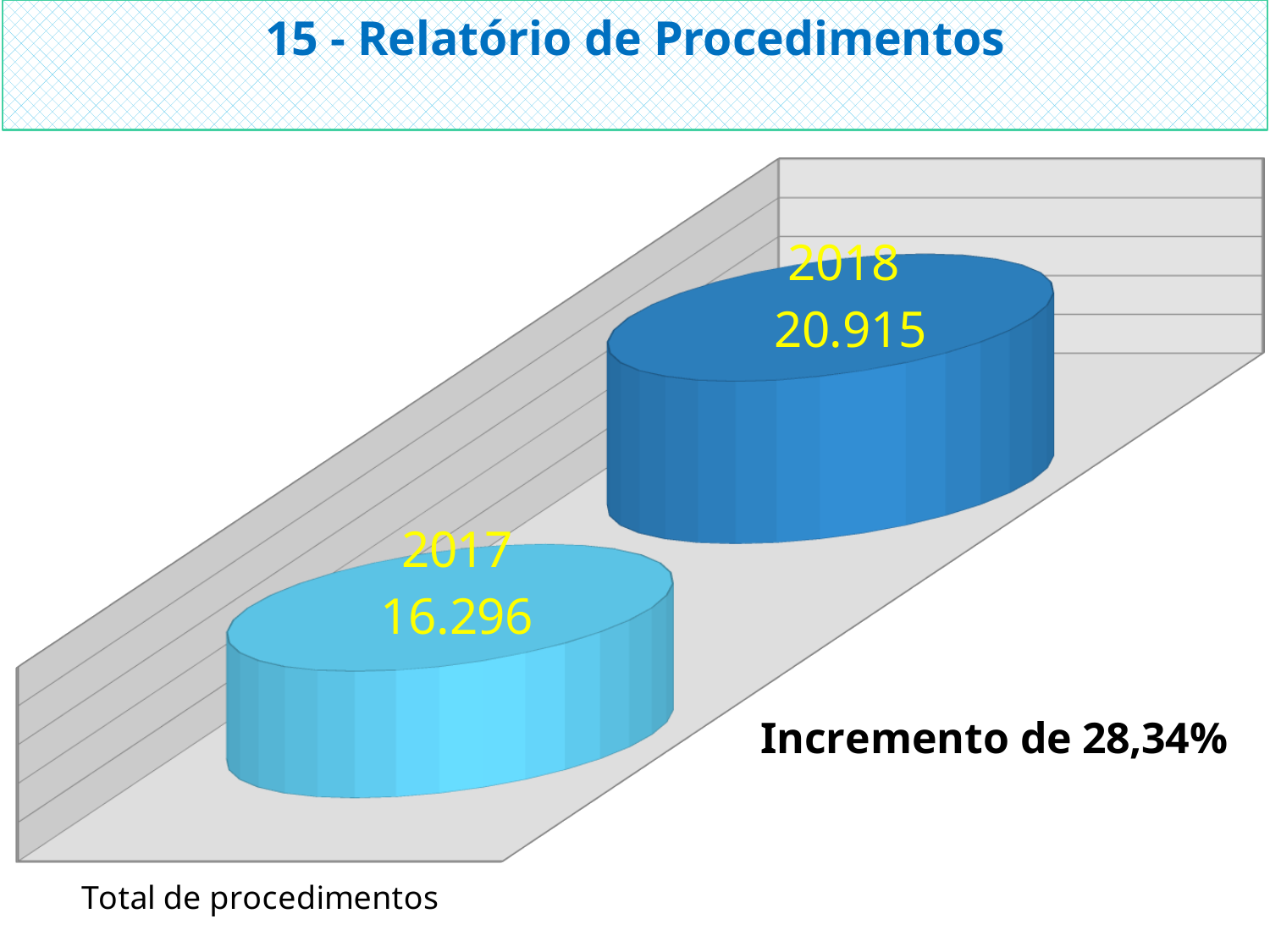
What is the value shown for 2017? 16.296 What kind of chart is shown on the slide? bar chart Is the value for 2018 larger or smaller than the value for 2017? larger How many categories (years) are plotted in the chart? 2 Which year has the higher value? 2018 What is the difference between the 2018 value and the 2017 value? 4.619 Do the values rise or fall from 2017 to 2018? rise What is the value shown for 2018? 20.915 What percentage increase is stated on the slide? 28,34% What is the label written below the chart? Total de procedimentos Which year has the lower value? 2017